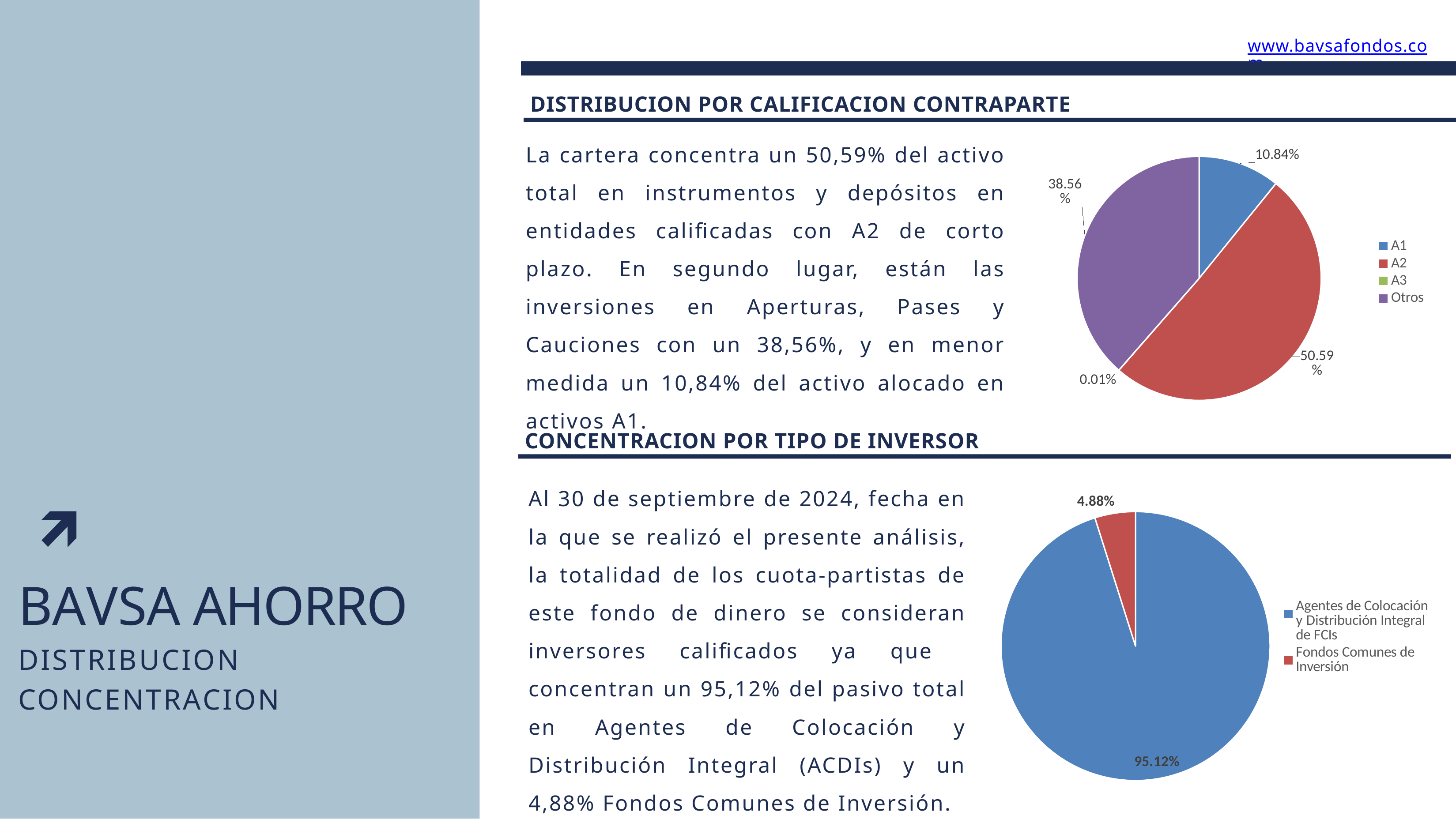
In the top chart (Distribucion por Calificacion Contraparte), what share does Otros have? 38.56% In the top chart (Distribucion por Calificacion Contraparte), what share does A1 have? 10.84% In the bottom chart (Concentracion por Tipo de Inversor), what share do Fondos Comunes de Inversión have? 4.88% In the top chart (Distribucion por Calificacion Contraparte), what is the difference between the A2 share and the Otros share? 12.03% In the top chart (Distribucion por Calificacion Contraparte), how many categories does the legend list? 4 What type of chart is the bottom chart (Concentracion por Tipo de Inversor)? Pie chart In the bottom chart (Concentracion por Tipo de Inversor), what share do Agentes de Colocación y Distribución Integral de FCIs have? 95.12% In the bottom chart (Concentracion por Tipo de Inversor), which colour represents Fondos Comunes de Inversión? Red In the top chart (Distribucion por Calificacion Contraparte), which category has the smallest slice? A3 In the top chart (Distribucion por Calificacion Contraparte), which category has the largest slice? A2 In the top chart (Distribucion por Calificacion Contraparte), what share does A2 have? 50.59% In the top chart (Distribucion por Calificacion Contraparte), what share does A3 have? 0.01%